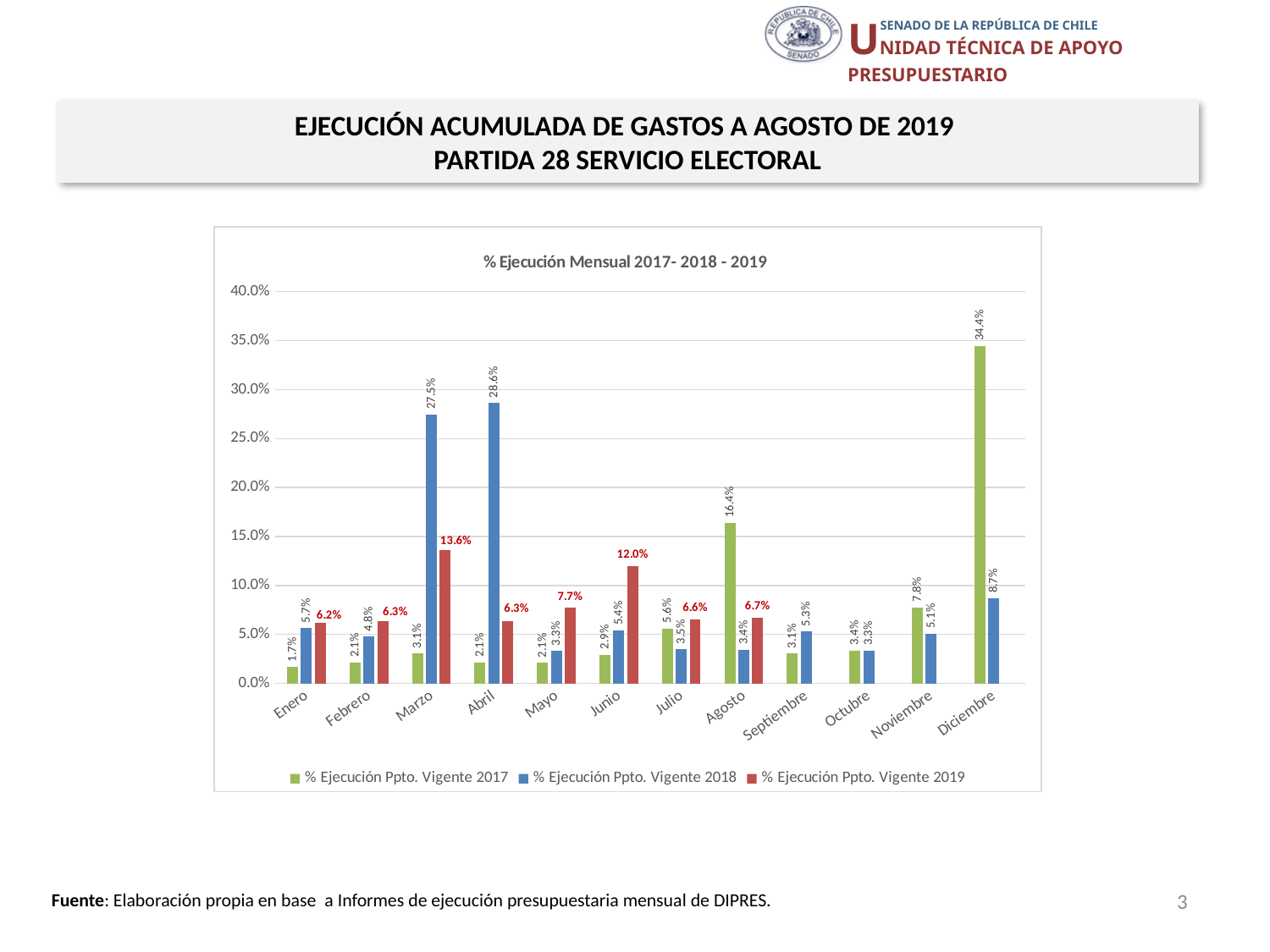
What is the difference between the 2018 and 2017 values in Abril? 26.5% What is the value for % Ejecución Ppto. Vigente 2017 in Agosto? 16.4% Which month has the highest value for % Ejecución Ppto. Vigente 2019? Marzo What is the value for % Ejecución Ppto. Vigente 2018 in Marzo? 27.5% What kind of chart is shown on the slide? Bar chart How many months are shown on the x axis? 12 What is the value for % Ejecución Ppto. Vigente 2019 in Junio? 12.0% What is the title of the chart? % Ejecución Mensual 2017- 2018 - 2019 Which month has the lowest value for % Ejecución Ppto. Vigente 2017? Enero How many series does the legend list? 3 In Julio, which series has the larger value: % Ejecución Ppto. Vigente 2017 or % Ejecución Ppto. Vigente 2018? % Ejecución Ppto. Vigente 2017 Which month has the highest value for % Ejecución Ppto. Vigente 2017? Diciembre